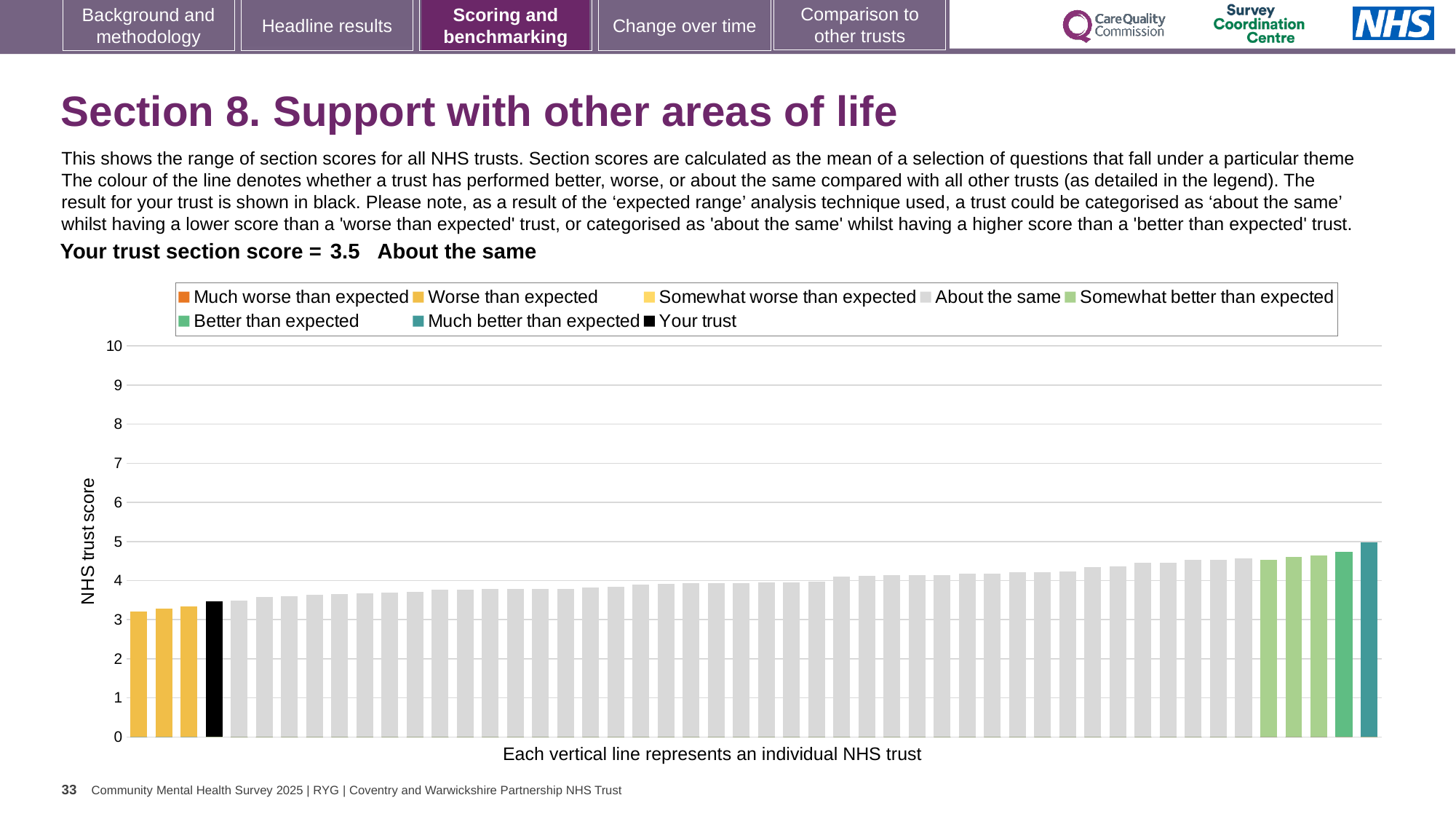
Is the value for your trust greater or less than 4? less Do the bar values rise or fall from left to right along the x axis? rise What kind of chart is shown on the slide? bar chart What does the black bar in the chart represent? Your trust Is the value for your trust greater or less than 3? greater Is the value of the tallest bar greater or less than 6? less Which legend category does the tallest bar belong to? Much better than expected What is the section score for your trust shown on the slide? 3.5 How many entries does the chart legend list? 8